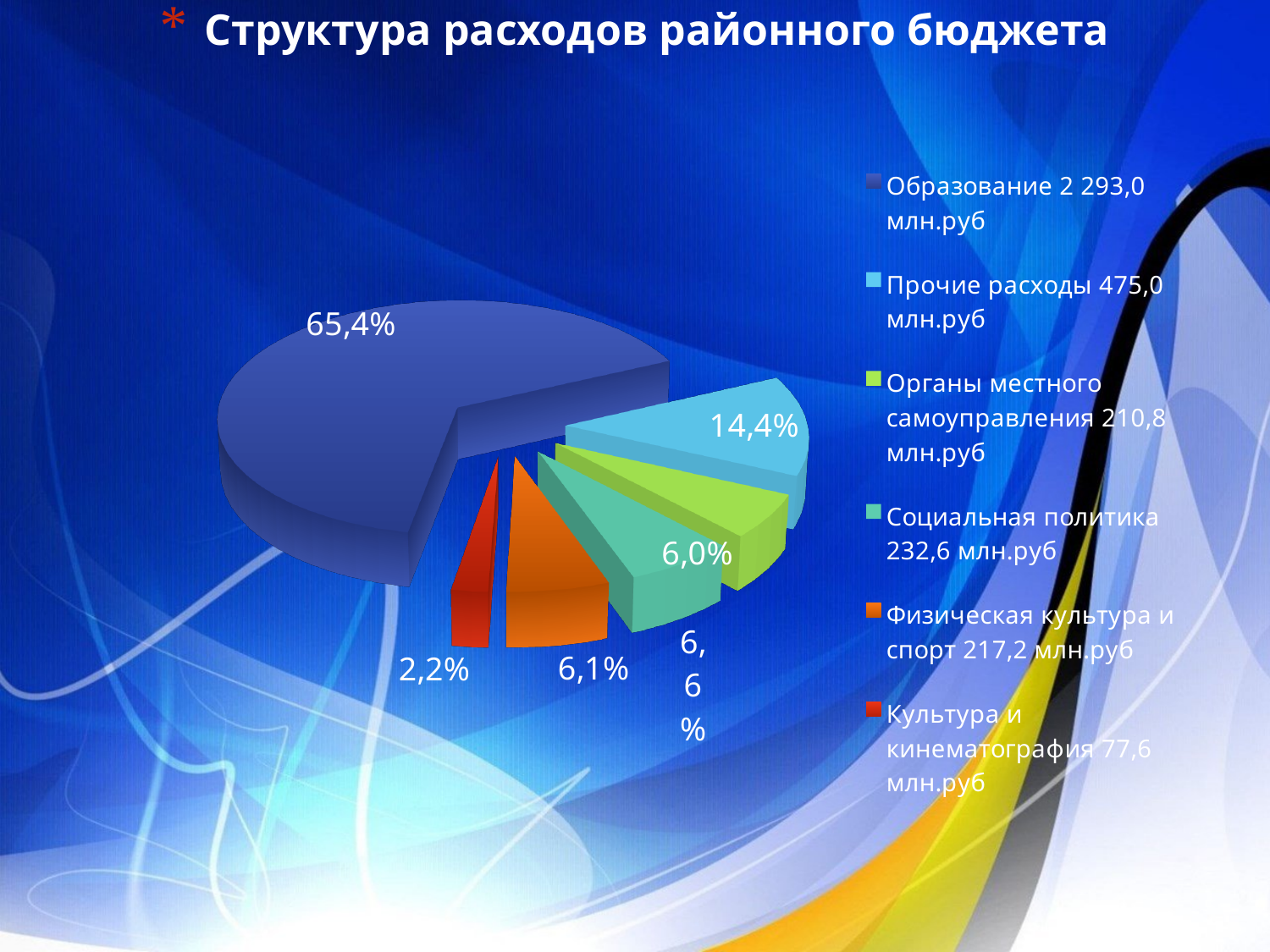
What share of the pie does Прочие расходы take? 14,4% Which category has the largest slice of the pie? Образование What kind of chart is shown on the slide? pie chart How many categories does the legend of the pie chart list? 6 What is the title of the chart on the slide? Структура расходов районного бюджета What share of the pie does Социальная политика take? 6,6% Which category has the smallest slice of the pie? Культура и кинематография What share of the pie does Культура и кинематография take? 2,2% According to the legend, what amount in млн.руб is given for Физическая культура и спорт? 217,2 млн.руб Which slice is larger: Прочие расходы or Органы местного самоуправления? Прочие расходы What is the difference in percentage points between the Образование slice and the Прочие расходы slice? 51,0%